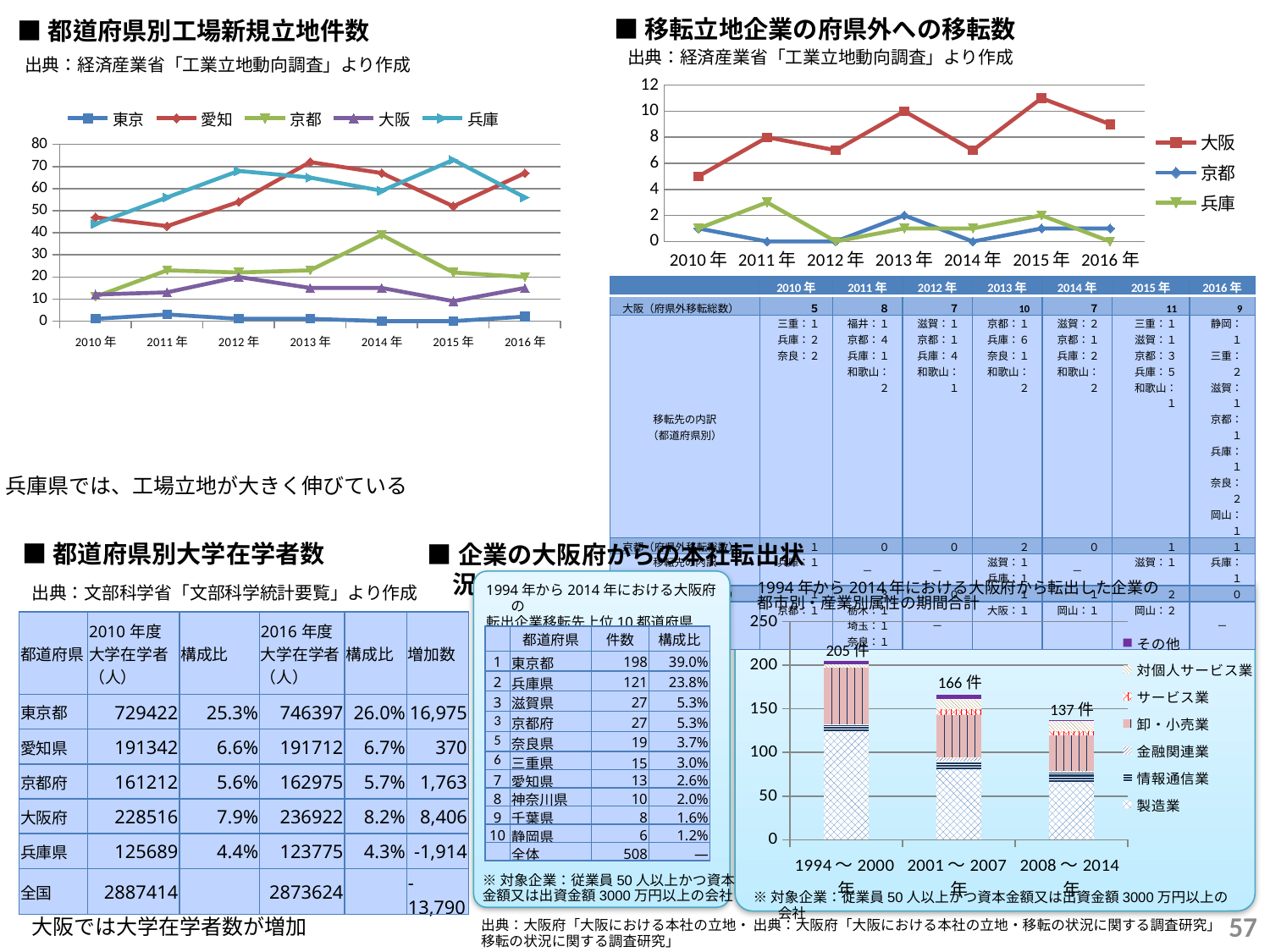
In the top-left chart titled 都道府県別工場新規立地件数, how many series does the legend list? 5 In the top-right chart titled 移転立地企業の府県外への移転数, what is the value for 大阪 in 2013年? 10 In the top-left chart titled 都道府県別工場新規立地件数, is the value for 兵庫 in 2015年 greater or less than 60? greater In the bottom-right stacked bar chart about 企業の大阪府からの本社転出状況, what is the total for 1994～2000年? 205件 In the top-right chart titled 移転立地企業の府県外への移転数, which series has the highest value in 2015年? 大阪 In the bottom-right stacked bar chart about 企業の大阪府からの本社転出状況, do the bar totals rise or fall from 1994～2000年 to 2008～2014年? fall In the top-left chart titled 都道府県別工場新規立地件数, is the value for 東京 in 2011年 greater or less than 10? less In the bottom-right stacked bar chart about 企業の大阪府からの本社転出状況, what is the difference between the totals for 1994～2000年 and 2008～2014年? 68件 In the top-left chart titled 都道府県別工場新規立地件数, which prefecture has the highest value in 2015年? 兵庫 In the top-right chart titled 移転立地企業の府県外への移転数, is the value for 大阪 in 2015年 greater or less than 10? greater In the top-left chart titled 都道府県別工場新規立地件数, which prefecture has the lowest value in 2016年? 東京 In the top-left chart titled 都道府県別工場新規立地件数, what kind of chart is it? line chart